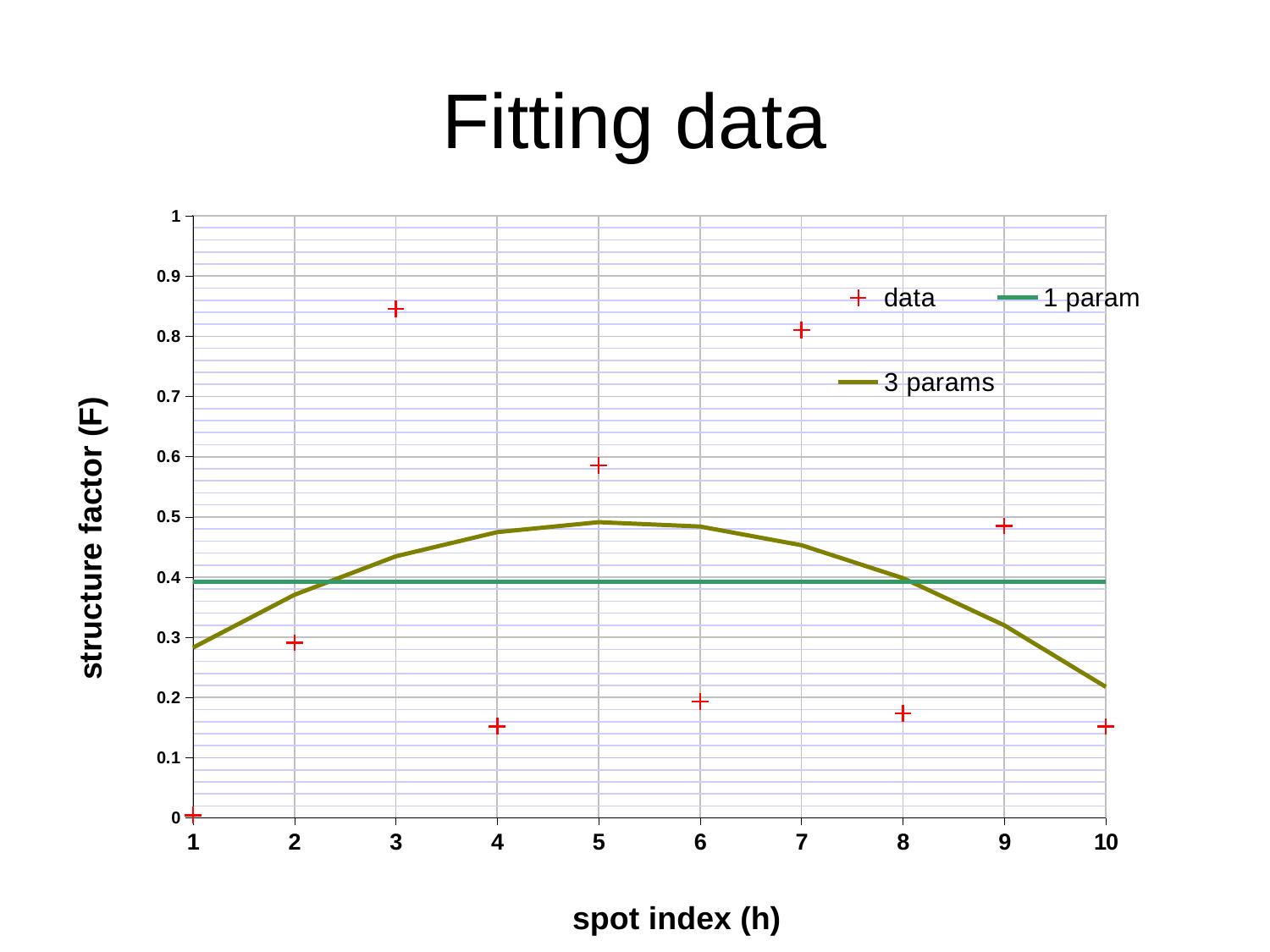
Which is larger, the 'data' value at spot index 5 or at spot index 9? spot index 5 At which spot index is the 'data' value lowest? 1 How many series does the legend list? 3 Is the 'data' value at spot index 3 greater or less than 0.8? greater At which spot index is the 'data' value highest? 3 How does the '3 params' curve change as the spot index increases from 1 to 10? rises to a peak at spot index 5, then falls What kind of chart is shown on the slide? scatter chart with fitted lines Is the 'data' value at spot index 5 greater or less than 0.5? greater What is the title of the y axis? structure factor (F) Is the 'data' value at spot index 4 greater or less than 0.2? less How many data points (red crosses) are plotted for the 'data' series? 10